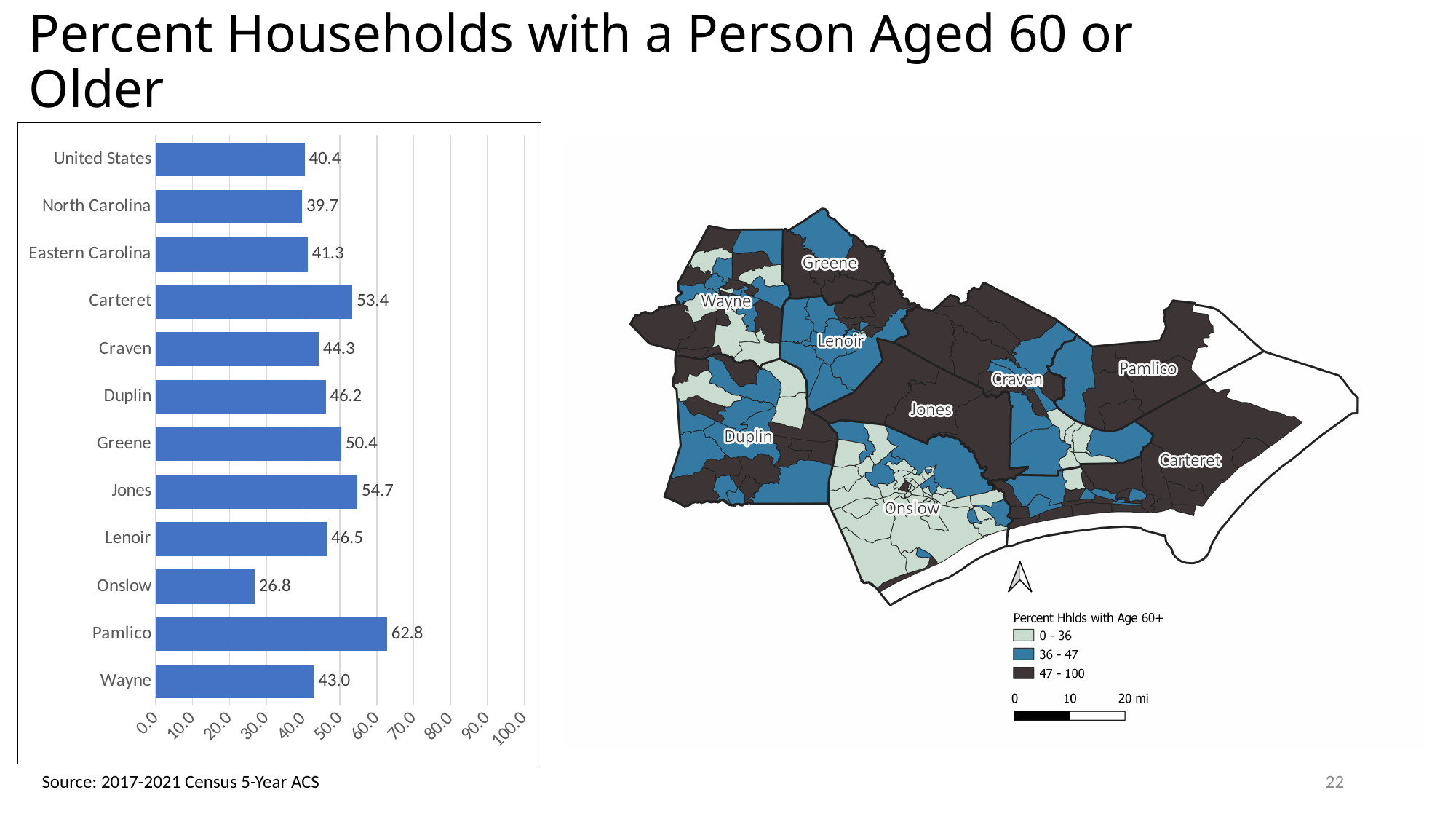
What is the value for Jones in the bar chart? 54.7 Which has a larger value in the bar chart, Jones or Carteret? Jones What is the value for Onslow in the bar chart? 26.8 Which category has the highest value in the bar chart? Pamlico Is the value for Wayne in the bar chart greater or less than 50.0? less What kind of chart is shown on the left of the slide? bar chart What is the value for Pamlico in the bar chart? 62.8 How many categories are shown in the bar chart? 12 What is the difference between the values for Pamlico and Onslow in the bar chart? 36.0 What is the value for North Carolina in the bar chart? 39.7 What is the difference between the values for Carteret and Craven in the bar chart? 9.1 Which category has the lowest value in the bar chart? Onslow